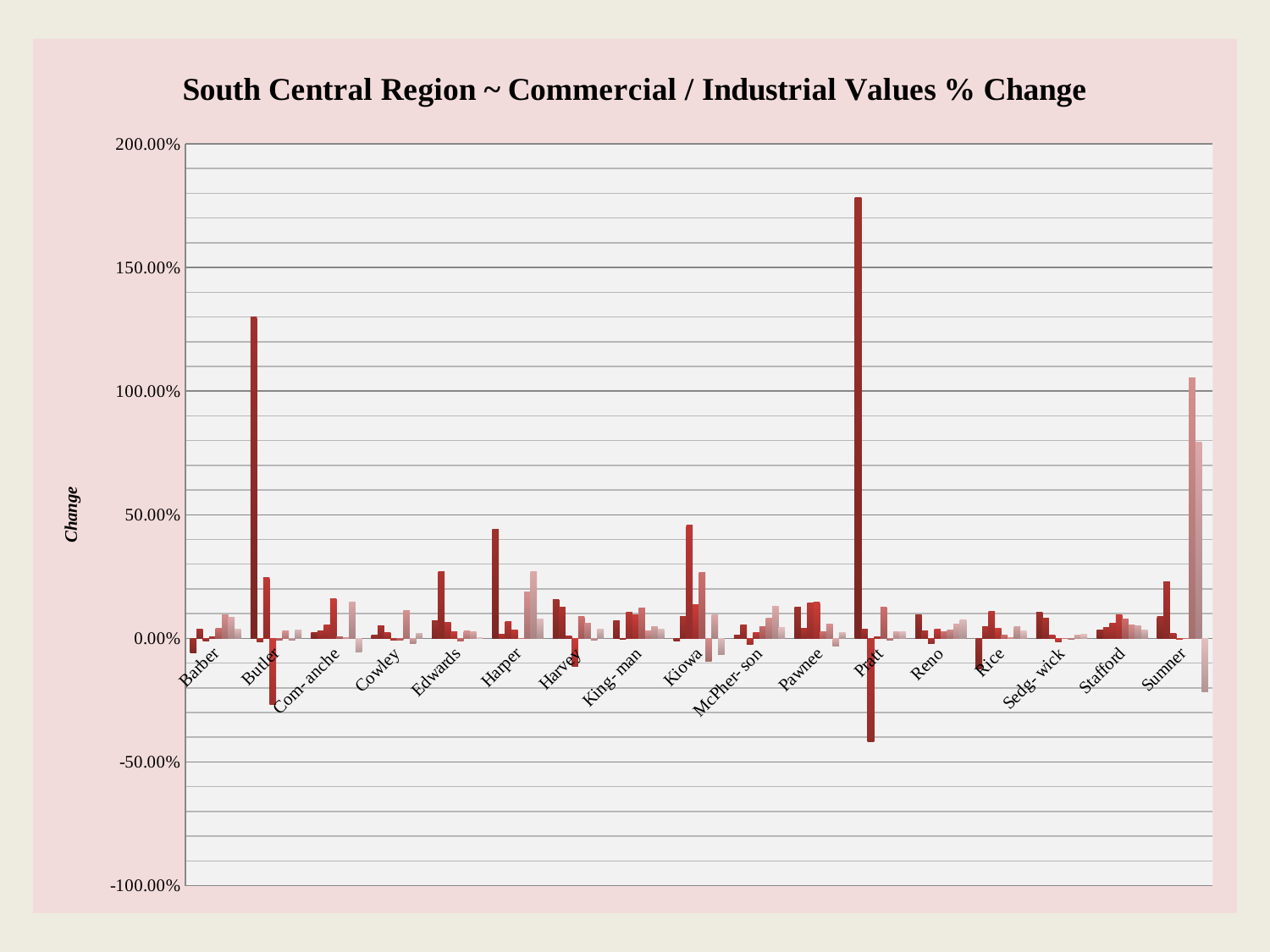
Is the tallest bar for Harper greater or less than 50.00%? less What kind of chart is shown on the slide? Bar chart Which county has the lowest (most negative) bar in the chart? Pratt Is the tallest bar for Sumner greater or less than 50.00%? greater Is the tallest bar for Pratt greater or less than 150.00%? greater What is the label on the vertical axis of the chart? Change How many counties (categories) are shown along the x axis of the chart? 17 What is the title of the chart? South Central Region ~ Commercial / Industrial Values % Change Which county has a taller maximum bar, Butler or Edwards? Butler Which county has a taller maximum bar, Kiowa or Cowley? Kiowa Which county has the tallest bar in the chart? Pratt